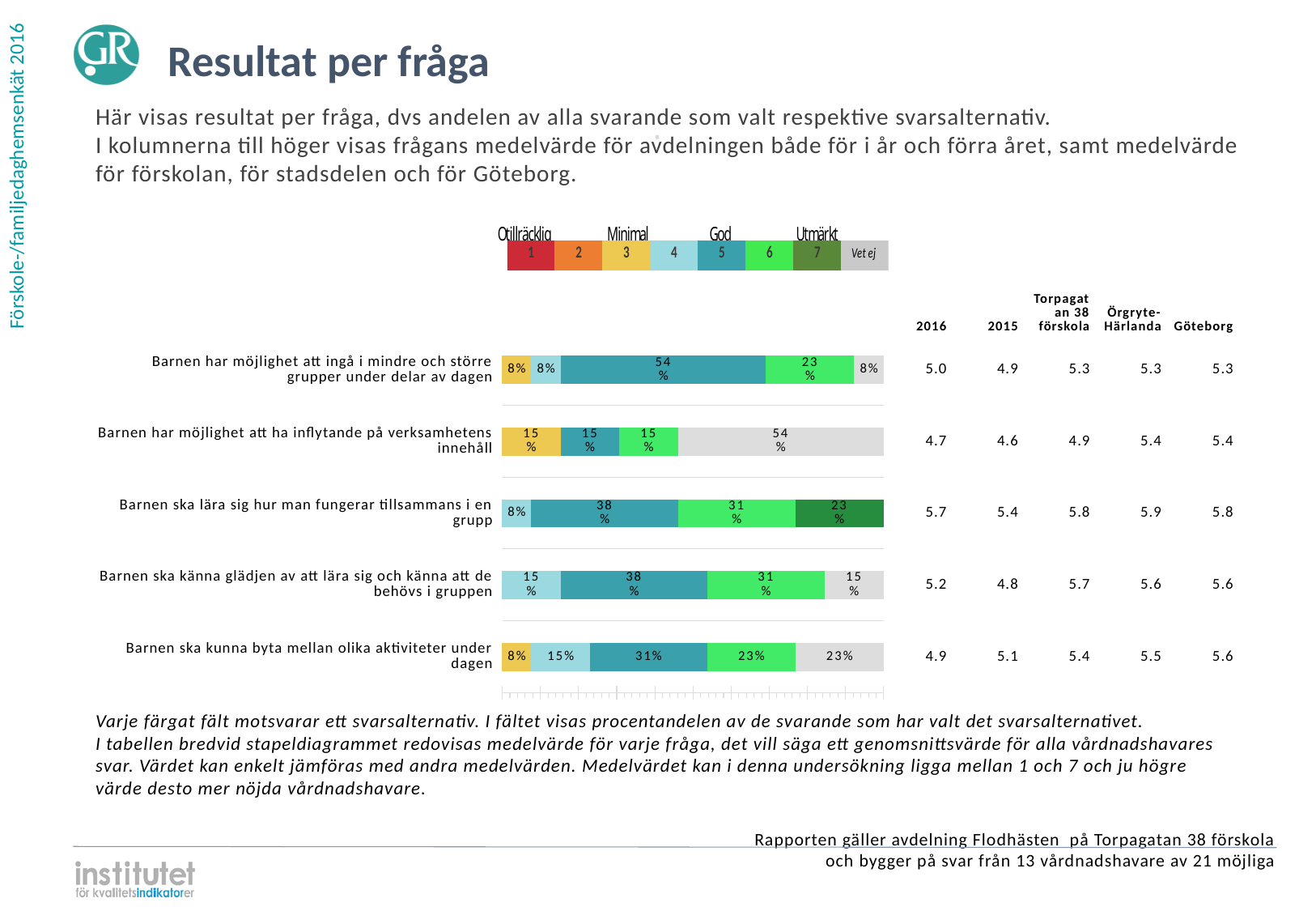
How many questions (bars) are shown in the chart? 5 How many response options does the legend above the chart list? 8 What kind of chart is used to show the results per question? Stacked bar chart What percentage of respondents chose option 5 (God, teal) for "Barnen har möjlighet att ingå i mindre och större grupper under delar av dagen"? 54% What percentage chose "Vet ej" for "Barnen har möjlighet att ha inflytande på verksamhetens innehåll"? 54% What is the 2016 mean value for "Barnen ska lära sig hur man fungerar tillsammans i en grupp"? 5.7 For "Barnen ska kunna byta mellan olika aktiviteter under dagen", what is the difference between the option 5 share (31%) and the option 6 share (23%)? 8% Which question has the lowest 2016 mean value in the table? Barnen har möjlighet att ha inflytande på verksamhetens innehåll What percentage chose option 7 (dark green) for "Barnen ska lära sig hur man fungerar tillsammans i en grupp"? 23% What label does the legend give to response options 5 and 6? God Which question has the largest "Vet ej" (grey) share? Barnen har möjlighet att ha inflytande på verksamhetens innehåll Which is larger for "Barnen ska känna glädjen av att lära sig och känna att de behövs i gruppen": the option 5 share or the option 6 share? Option 5 (38%)